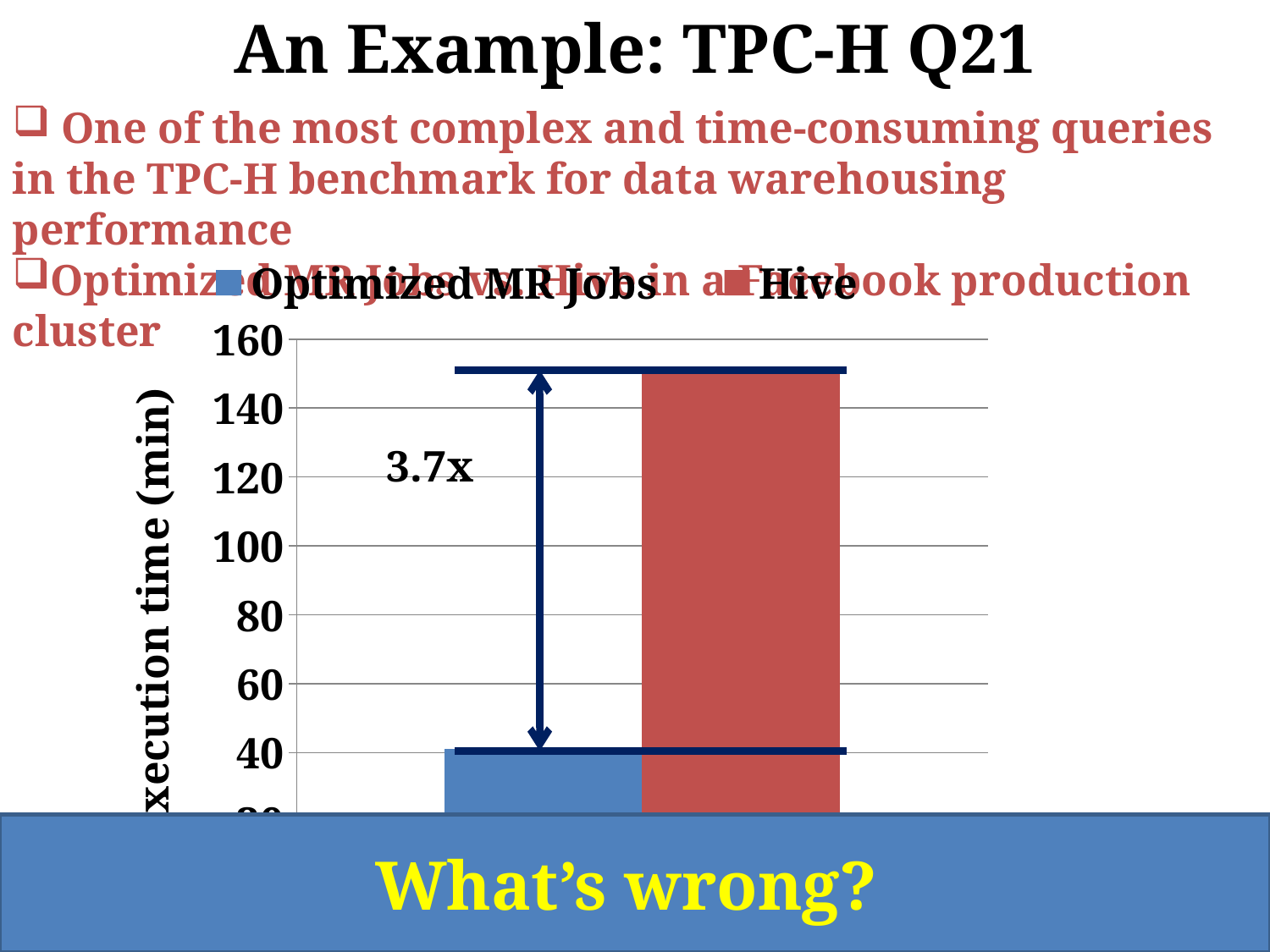
Is the execution time for Hive greater or less than 160? less Which series has the higher execution time, Optimized MR Jobs or Hive? Hive Is the execution time for Optimized MR Jobs greater or less than 100? less Which series has the lowest bar in the chart? Optimized MR Jobs Is the execution time for Hive greater or less than 140? greater What colour is the Hive bar in the chart? red How many series does the chart legend list? 2 What kind of chart is shown on the slide? bar chart What speedup factor is annotated between the two bars in the chart? 3.7x Which series has the highest bar in the chart? Hive